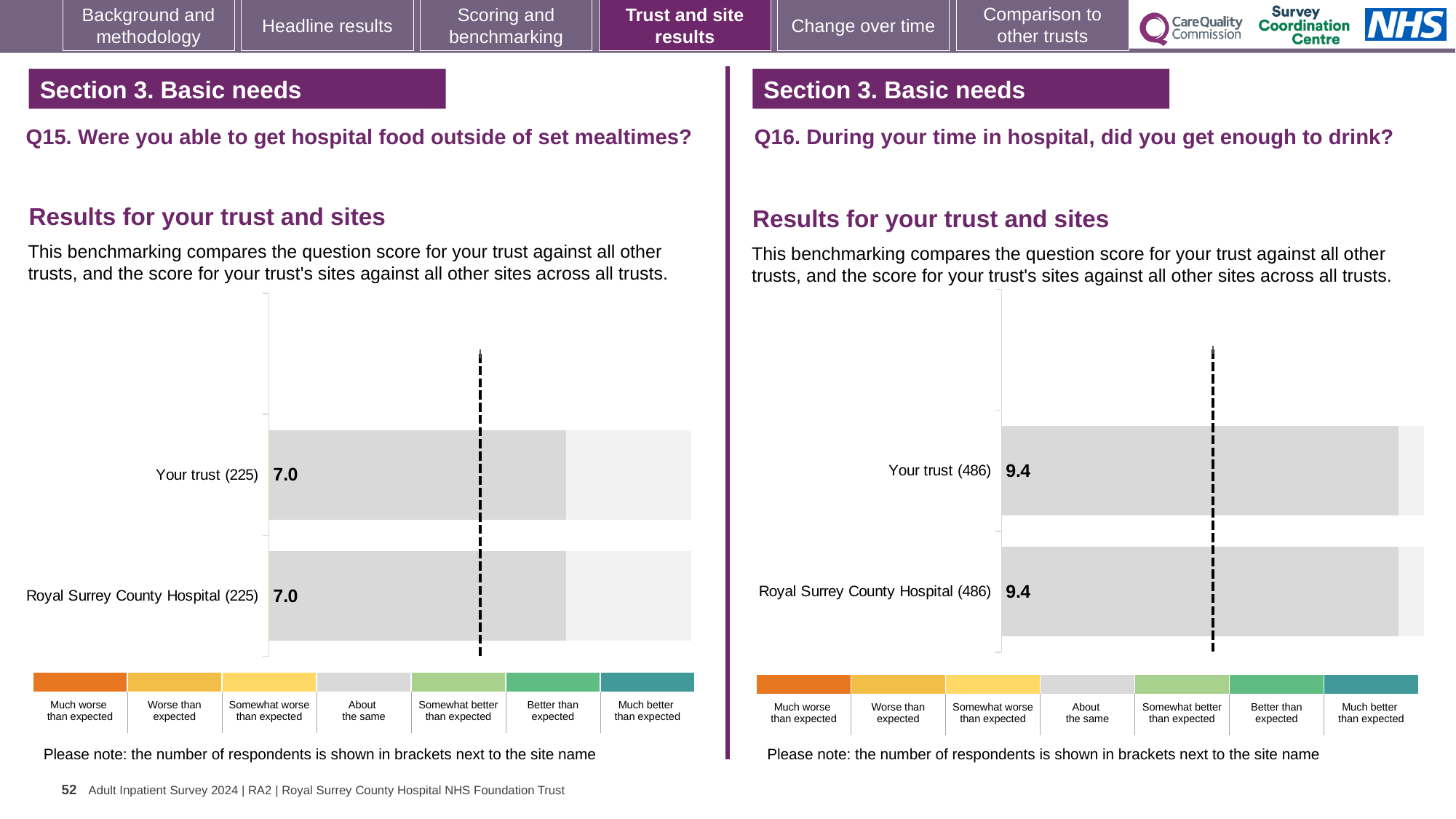
In the Q16 chart on the right, what is the difference between the score for Your trust and the score for Royal Surrey County Hospital? 0.0 In the Q16 chart on the right, how many respondents are shown in brackets for Royal Surrey County Hospital? 486 In the Q16 chart on the right, what is the score for Your trust? 9.4 Is the score for Your trust in the Q16 chart on the right larger or smaller than the score for Your trust in the Q15 chart on the left? Larger In the Q15 chart on the left, what is the difference between the score for Your trust and the score for Royal Surrey County Hospital? 0.0 In the Q15 chart on the left, what is the score for Your trust? 7.0 In the Q15 chart on the left, what is the score for Royal Surrey County Hospital? 7.0 In the Q15 chart on the left, how many respondents are shown in brackets for Your trust? 225 How many bars are plotted in the Q15 chart on the left? 2 In the Q16 chart on the right, what is the score for Royal Surrey County Hospital? 9.4 How many bars are plotted in the Q16 chart on the right? 2 What kind of chart is used for the Q15 results on the left? Bar chart